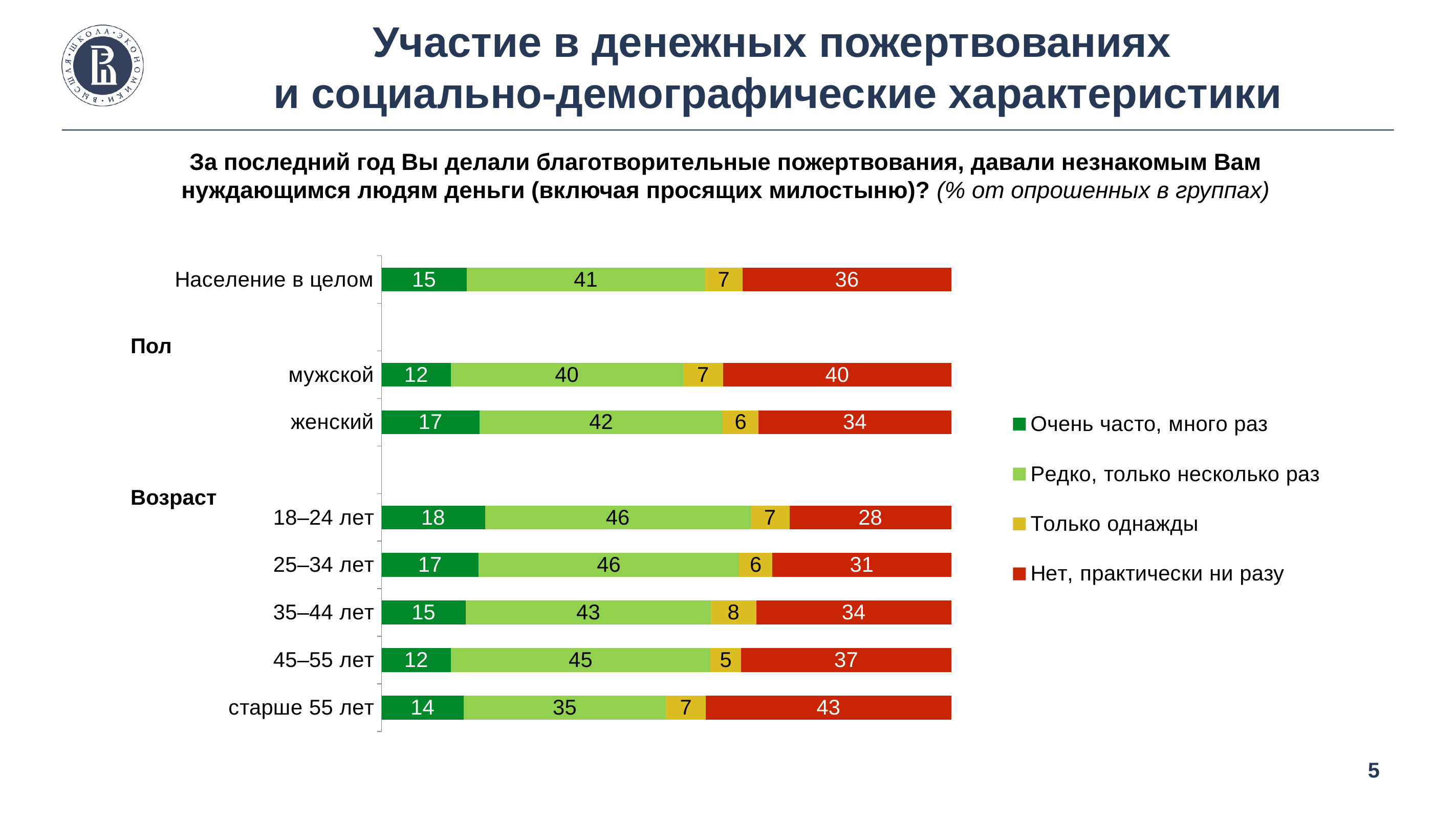
What is the total of the stacked bar for "35–44 лет"? 100 How many categories (bars) are plotted in the chart? 8 What kind of chart is shown on the slide? Stacked bar chart What is the value of "Нет, практически ни разу" for "Население в целом"? 36 Which category has the highest value for "Нет, практически ни разу"? старше 55 лет What is the difference between the "Нет, практически ни разу" values for "мужской" and "женский"? 6 How many series does the legend list? 4 What is the value of "Редко, только несколько раз" for "старше 55 лет"? 35 Which colour represents "Только однажды" in the legend? Yellow Which has a larger "Очень часто, много раз" value: "18–24 лет" or "45–55 лет"? 18–24 лет What is the value of "Очень часто, много раз" for "женский"? 17 Which category has the lowest value for "Нет, практически ни разу"? 18–24 лет